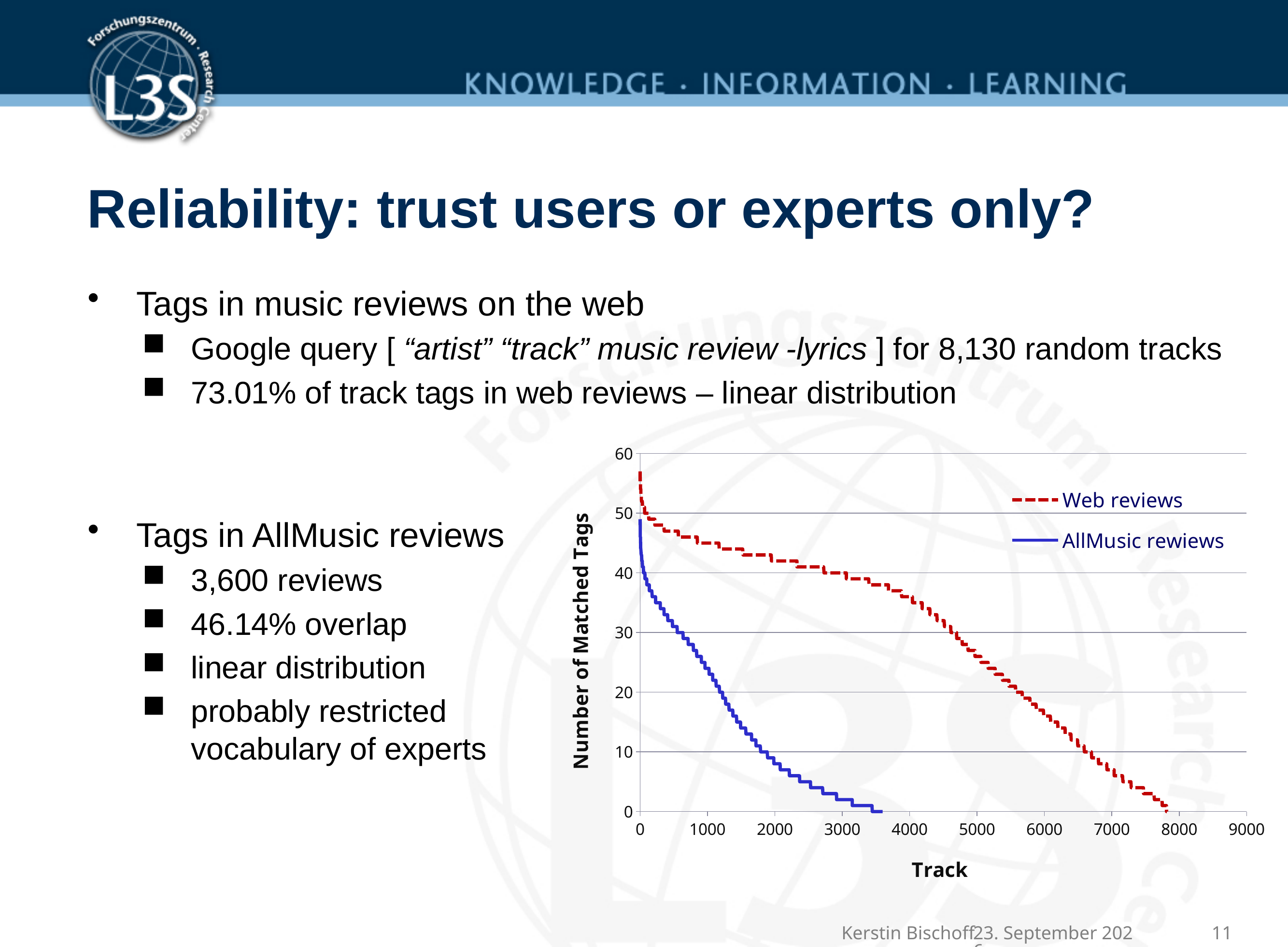
Is the value of the AllMusic rewiews series at track 1000 greater or less than 30? less Do the values of the AllMusic rewiews series rise or fall along the x axis? fall Which series reaches zero matched tags at a lower track number, Web reviews or AllMusic rewiews? AllMusic rewiews Is the value of the AllMusic rewiews series at track 3000 greater or less than 10? less Is the value of the Web reviews series at track 4000 greater or less than 30? greater Do the values of the Web reviews series rise or fall as the track number increases along the x axis? fall At track 1000, which series has the higher number of matched tags, Web reviews or AllMusic rewiews? Web reviews What are the two series named in the chart legend? Web reviews and AllMusic rewiews What kind of chart is shown on the slide? line chart What is the label of the y axis of the chart? Number of Matched Tags How many series does the chart legend list? 2